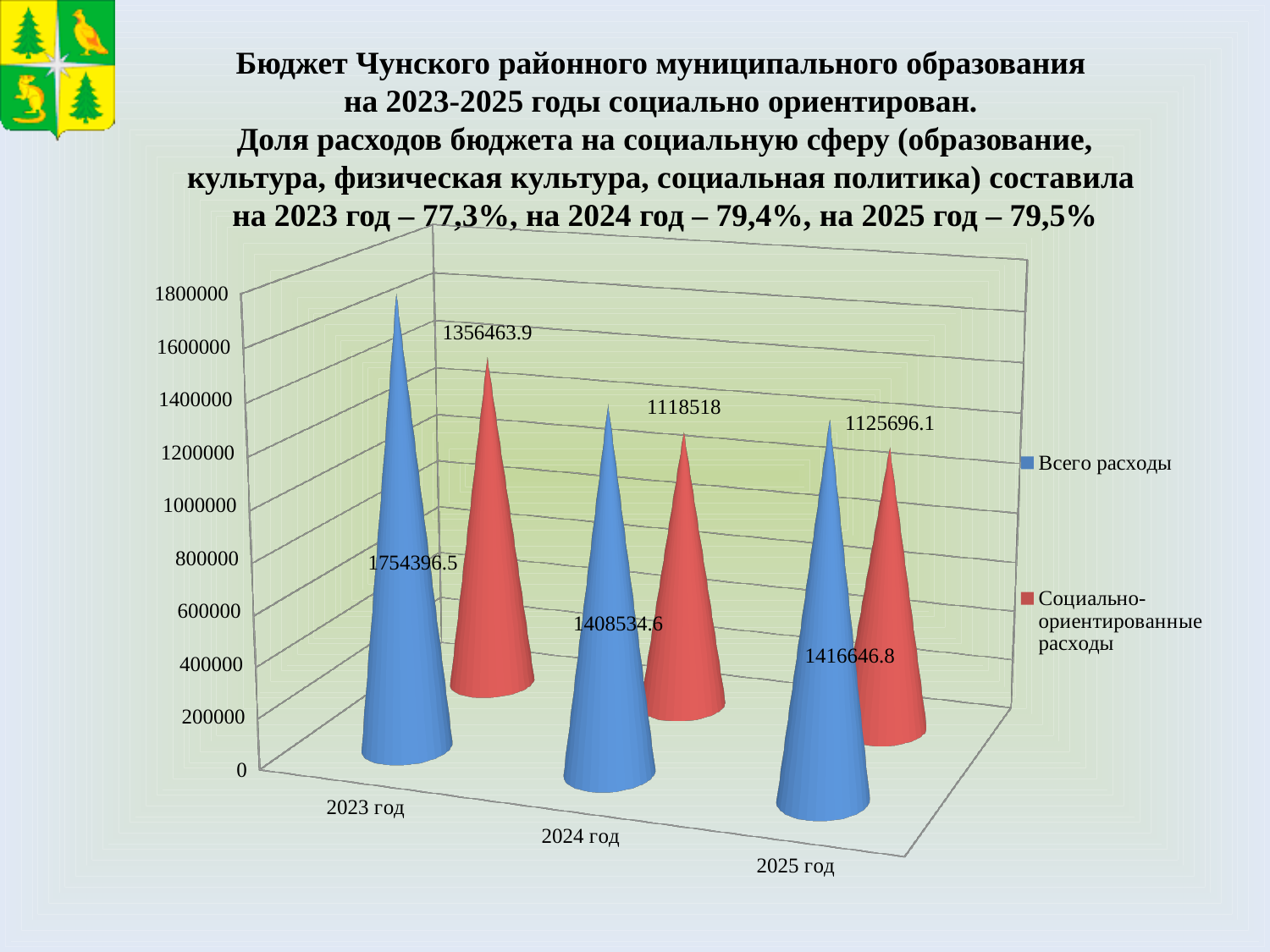
What is the value of Социально-ориентированные расходы for 2025 год? 1125696.1 In which year is Социально-ориентированные расходы the lowest? 2024 год What is the value of Социально-ориентированные расходы for 2024 год? 1118518 Which is larger: Всего расходы in 2024 год or Всего расходы in 2025 год? Всего расходы in 2025 год What is the value of Всего расходы for 2023 год? 1754396.5 Is the value of Социально-ориентированные расходы for 2023 год greater or less than 1200000? greater How many series does the legend list? 2 What is the value of Всего расходы for 2025 год? 1416646.8 Does Всего расходы rise or fall from 2023 год to 2024 год? fall In which year is Всего расходы the highest? 2023 год How many years are shown on the x axis? 3 What is the difference between Всего расходы and Социально-ориентированные расходы in 2023 год? 397932.6